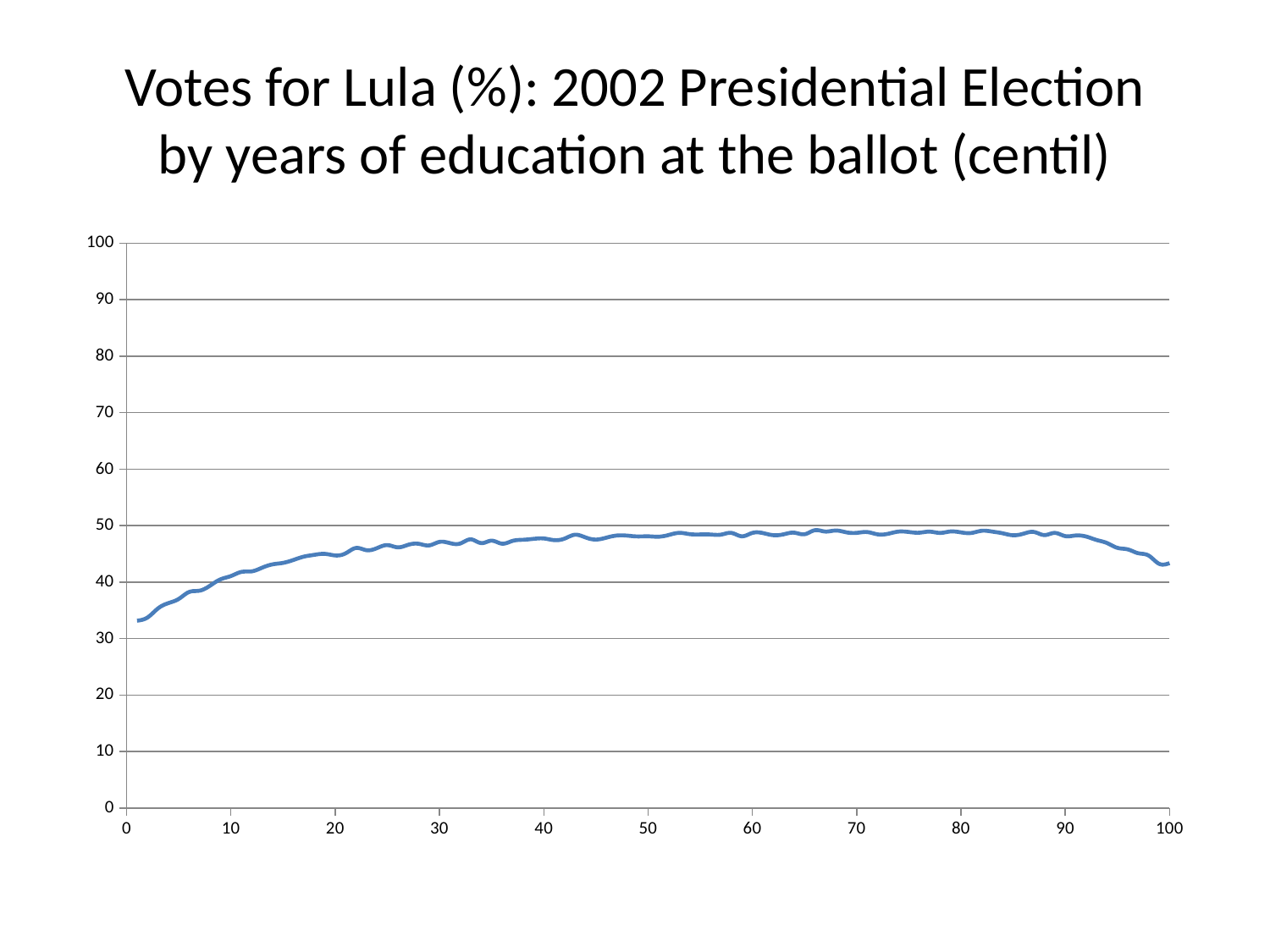
Between centil 90 and centil 100, does the line rise or fall? fall How many lines are plotted on the chart? 1 Is the value at centil 50 greater or less than 40? greater Is the value at centil 100 greater or less than 50? less What is the title of the chart? Votes for Lula (%): 2002 Presidential Election by years of education at the ballot (centil) Is the value at centil 20 greater or less than 40? greater What kind of chart is shown on the slide? line chart Between centil 0 and centil 20, does the line rise or fall? rise Which is larger: the value at centil 1 or the value at centil 100? centil 100 At which end of the x axis does the line reach its lowest value? the left end (centil 1)